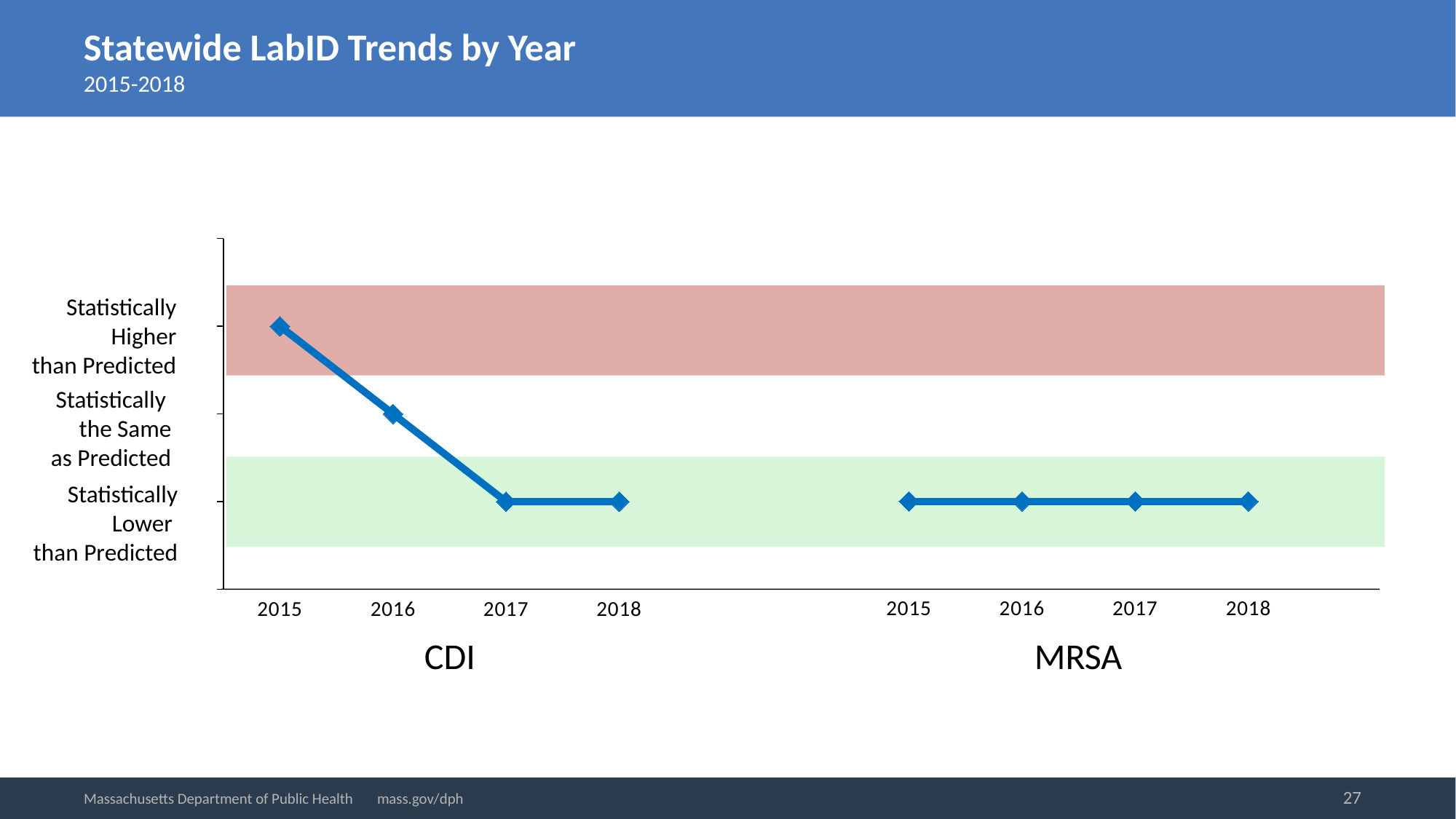
What is the CDI category for 2018? Statistically Lower than Predicted What is the CDI category for 2017? Statistically Lower than Predicted What is the CDI category for 2015? Statistically Higher than Predicted What is the MRSA category for 2018? Statistically Lower than Predicted Does the MRSA line rise, fall, or stay flat from 2015 to 2018? stay flat How many data points are plotted in total across CDI and MRSA? 8 How many years are plotted for CDI? 4 What kind of chart is shown on the slide? line chart What is the CDI category for 2016? Statistically the Same as Predicted Does the CDI line rise or fall from 2015 to 2017? fall What is the MRSA category for 2015? Statistically Lower than Predicted What is the title of the chart slide? Statewide LabID Trends by Year